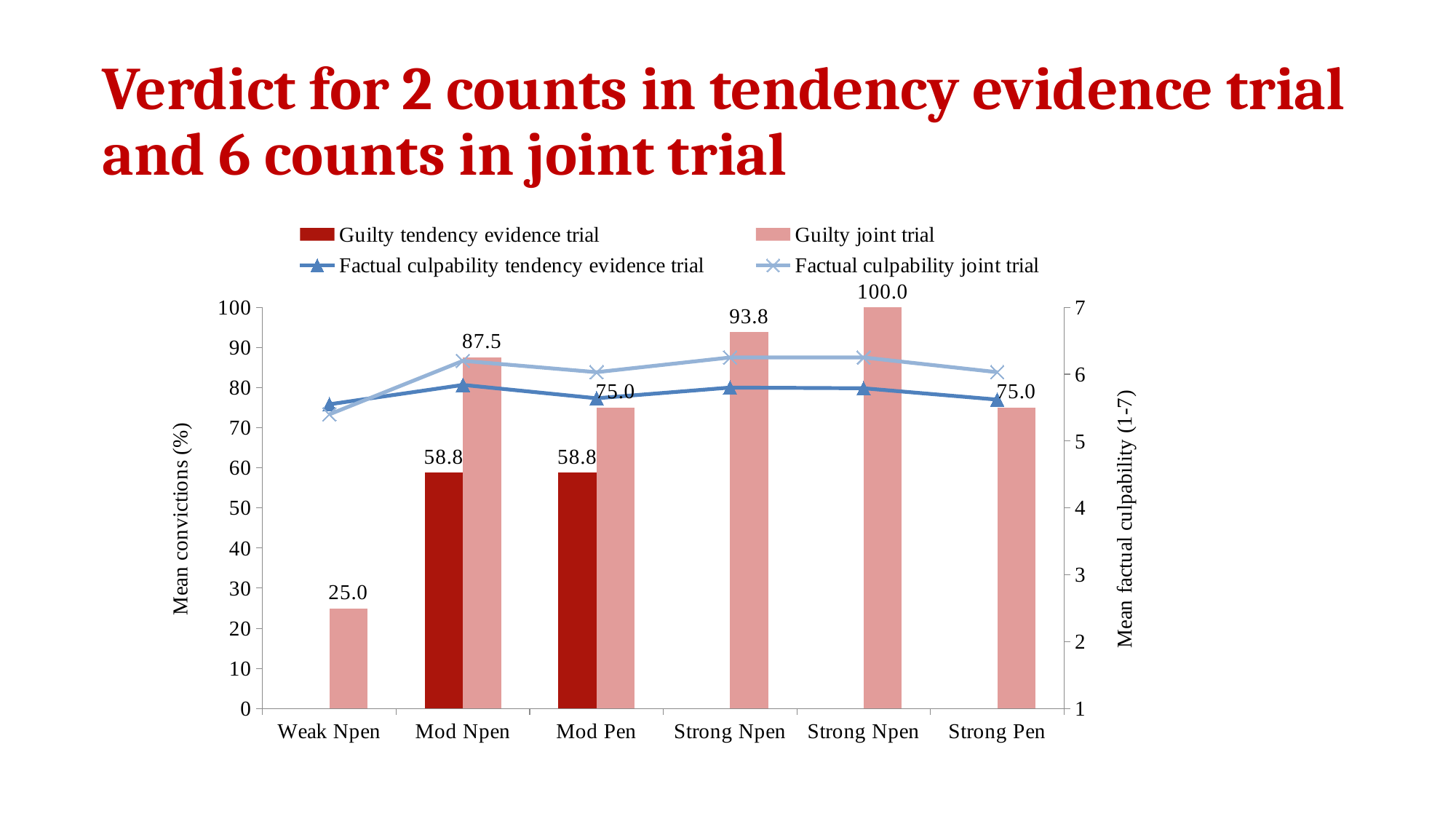
What is the value of the Guilty joint trial bar for Strong Pen? 75.0 Which is larger, the Guilty joint trial value for Mod Npen or for Mod Pen? Mod Npen What is the highest value shown for the Guilty joint trial series? 100.0 How many series does the legend list? 4 What is the value of the Guilty joint trial bar for Mod Npen? 87.5 What is the difference between the Guilty joint trial and Guilty tendency evidence trial values for Mod Npen? 28.7 Is the Factual culpability joint trial value for Weak Npen greater or less than 6 on the right axis? less What is the value of the Guilty joint trial bar for Weak Npen? 25.0 What kind of chart is shown on the slide? Combination bar and line chart How many categories are shown on the x axis? 6 Which category has the lowest Guilty joint trial value? Weak Npen What is the value of the Guilty tendency evidence trial bar for Mod Pen? 58.8